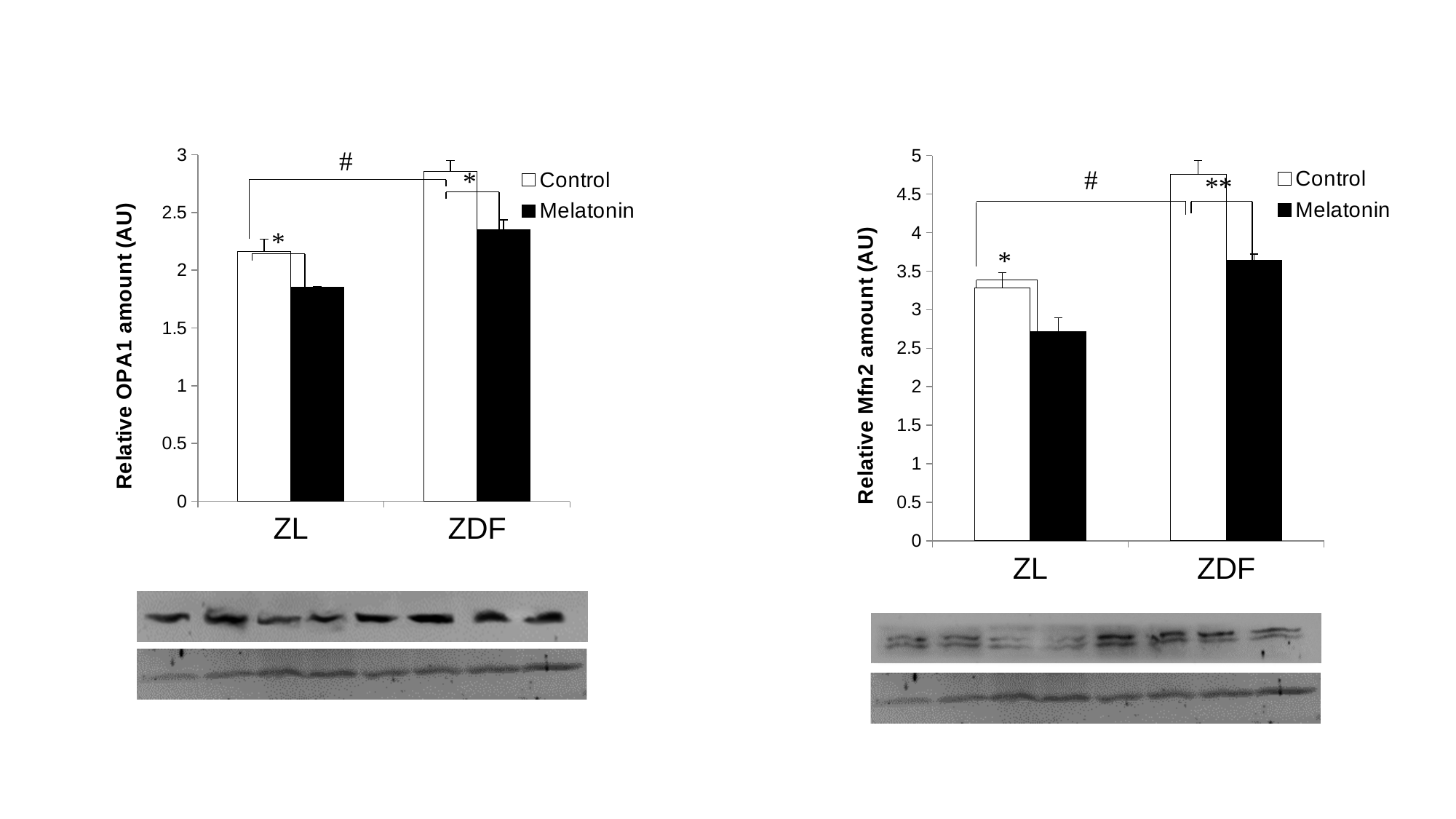
How many categories are shown on the x axis of the left chart (Relative OPA1 amount)? 2 In the right chart (Relative Mfn2 amount), is the Melatonin value for ZDF greater or less than 4? less In the left chart (Relative OPA1 amount), is the Control value for ZDF greater or less than 2.5? greater In the left chart (Relative OPA1 amount), is the Melatonin value for ZL greater or less than 2? less In the right chart (Relative Mfn2 amount), which category has the highest Control value, ZL or ZDF? ZDF What kind of chart is the left chart (Relative OPA1 amount)? bar chart How many series does the legend of the right chart (Relative Mfn2 amount) list? 2 In the left chart (Relative OPA1 amount), which is larger for ZDF, Control or Melatonin? Control What is the y-axis label of the right chart? Relative Mfn2 amount (AU)